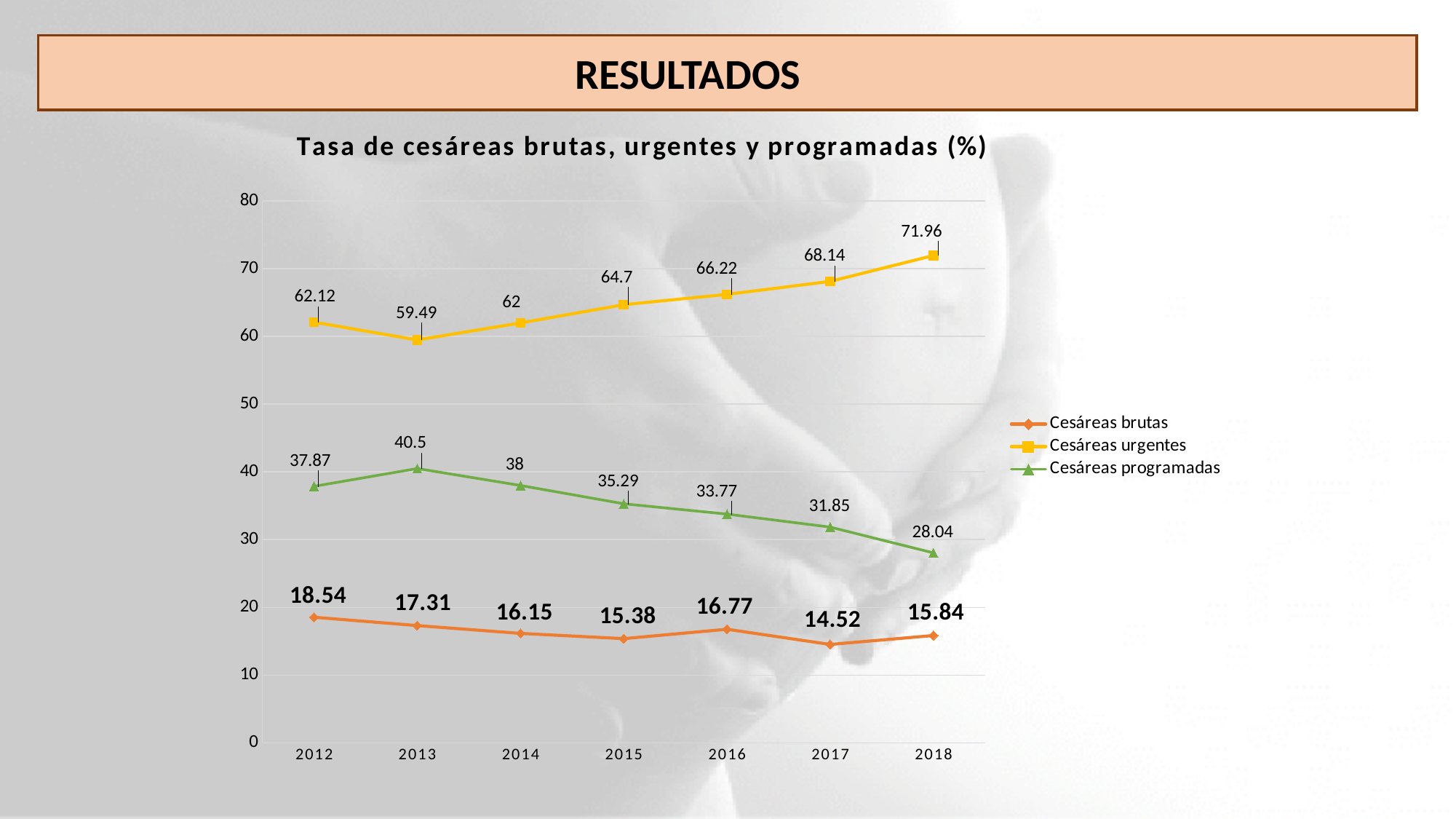
In which year is Cesáreas urgentes lowest? 2013 How many years are shown on the x axis? 7 In which year is Cesáreas programadas highest? 2013 What is the value for Cesáreas brutas in 2012? 18.54 How many series does the legend list? 3 Does Cesáreas programadas rise or fall from 2013 to 2018? Fall In which year is Cesáreas brutas lowest? 2017 What is the difference between Cesáreas urgentes in 2018 and in 2012? 9.84 What kind of chart is shown? Line chart What is the value for Cesáreas urgentes in 2018? 71.96 Which is larger: Cesáreas programadas in 2014 or in 2017? 2014 What is the value for Cesáreas programadas in 2013? 40.5